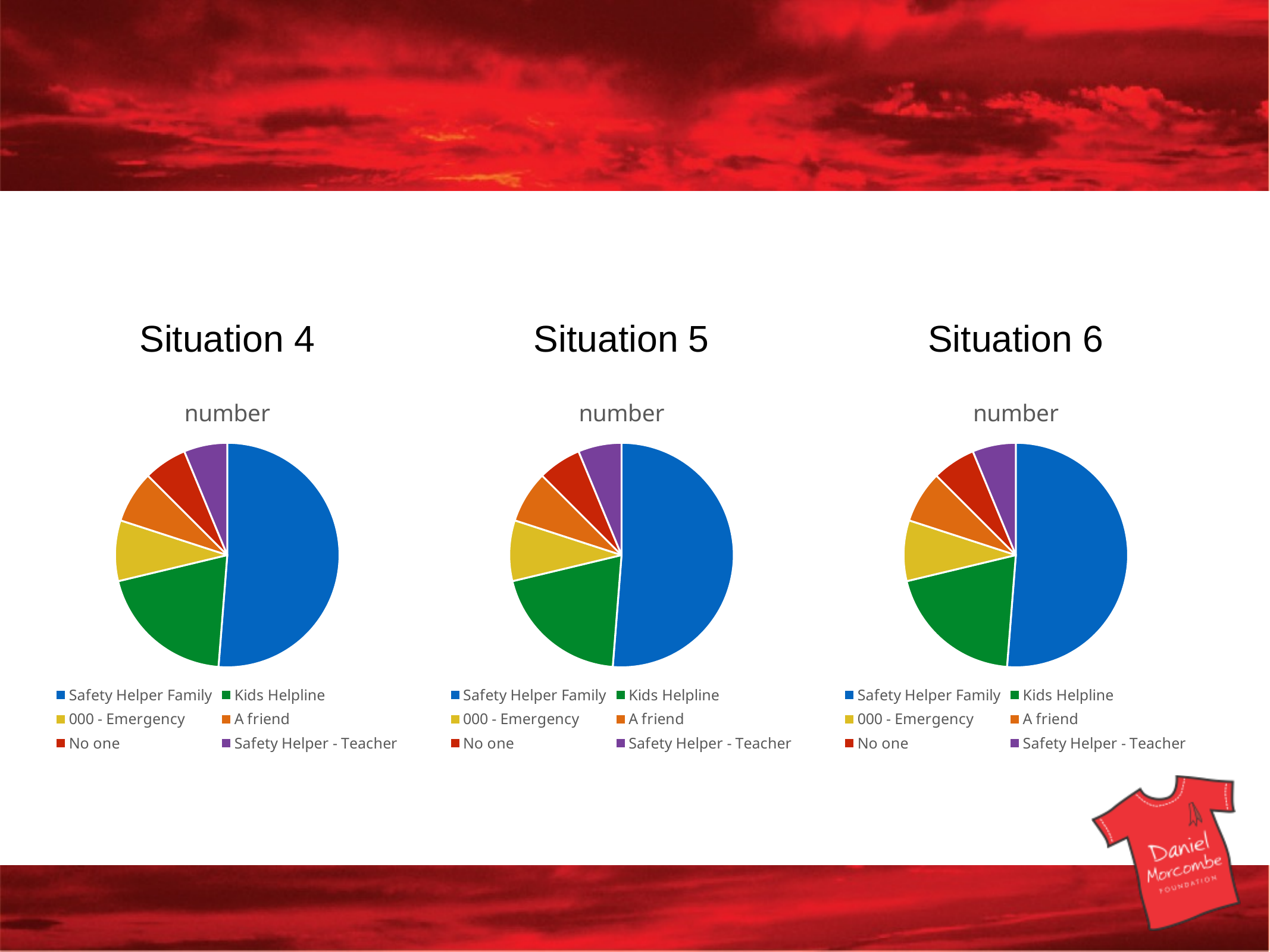
In the Situation 5 chart, what colour represents Kids Helpline? green What is the title shown above each of the three pie charts? number In the Situation 4 chart, which category has the largest slice? Safety Helper Family How many entries does the legend of the Situation 6 chart list? 6 How many slices does the Situation 5 pie chart have? 6 In the Situation 6 chart, which is larger: A friend or Kids Helpline? Kids Helpline In the Situation 5 chart, which is larger: Safety Helper Family or Kids Helpline? Safety Helper Family What kind of chart is used for Situation 4? pie chart In the Situation 4 chart, which is larger: Kids Helpline or 000 - Emergency? Kids Helpline In the Situation 6 chart, which category has the largest slice? Safety Helper Family In the Situation 5 chart, which category has the largest slice? Safety Helper Family